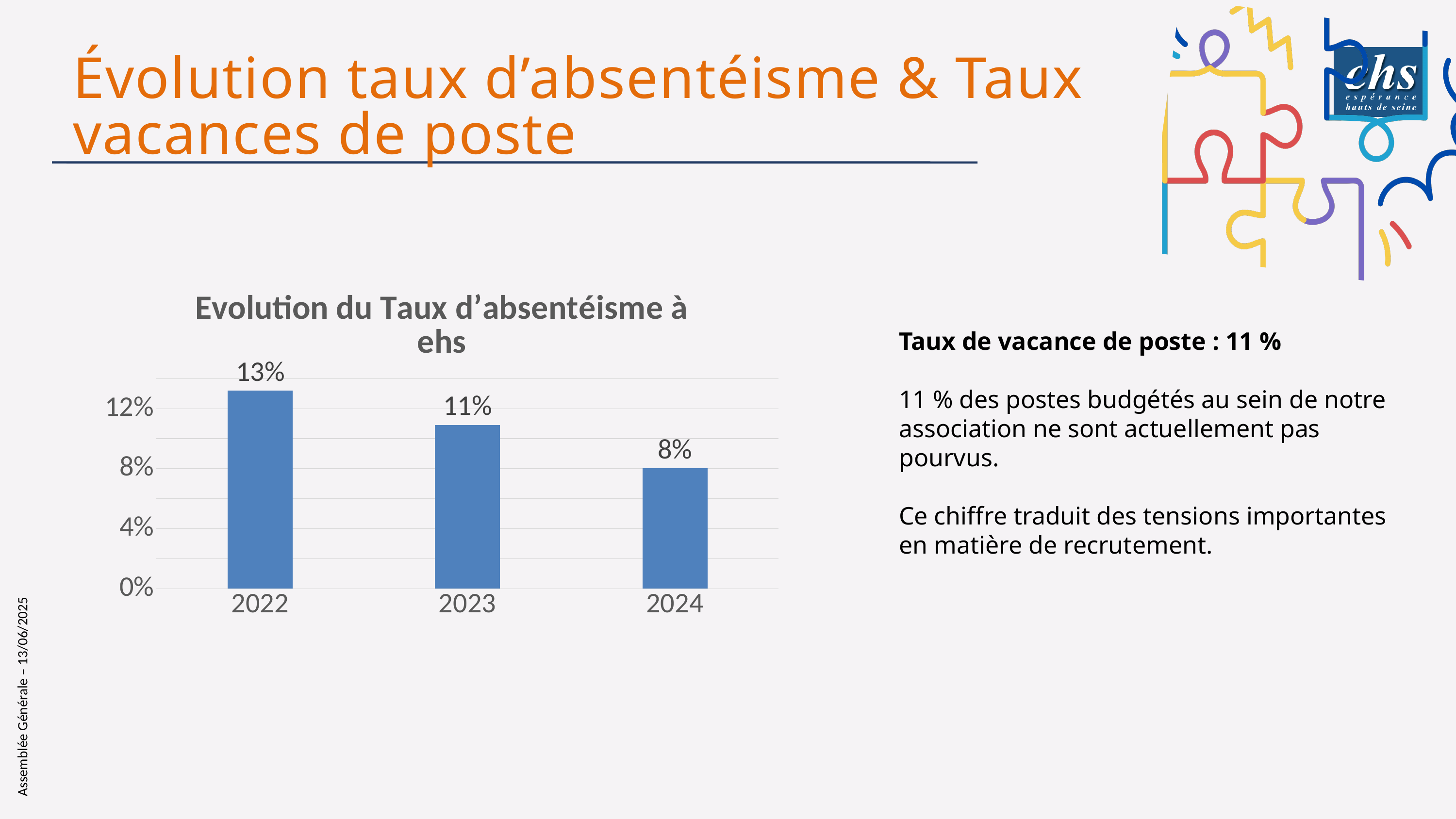
Does the absenteeism rate rise or fall from 2022 to 2024? Fall What kind of chart is shown on the slide? Bar chart What is the absenteeism rate shown for 2023? 11% What is the absenteeism rate shown for 2024? 8% How many years are shown on the chart? 3 What is the difference between the absenteeism rate in 2022 and in 2023? 2% Is the value for 2023 greater or less than 8%? greater Which year has the lowest absenteeism rate? 2024 Which year has the highest absenteeism rate? 2022 Which year has a higher absenteeism rate, 2023 or 2024? 2023 What is the difference between the absenteeism rate in 2022 and in 2024? 5% What is the absenteeism rate shown for 2022? 13%